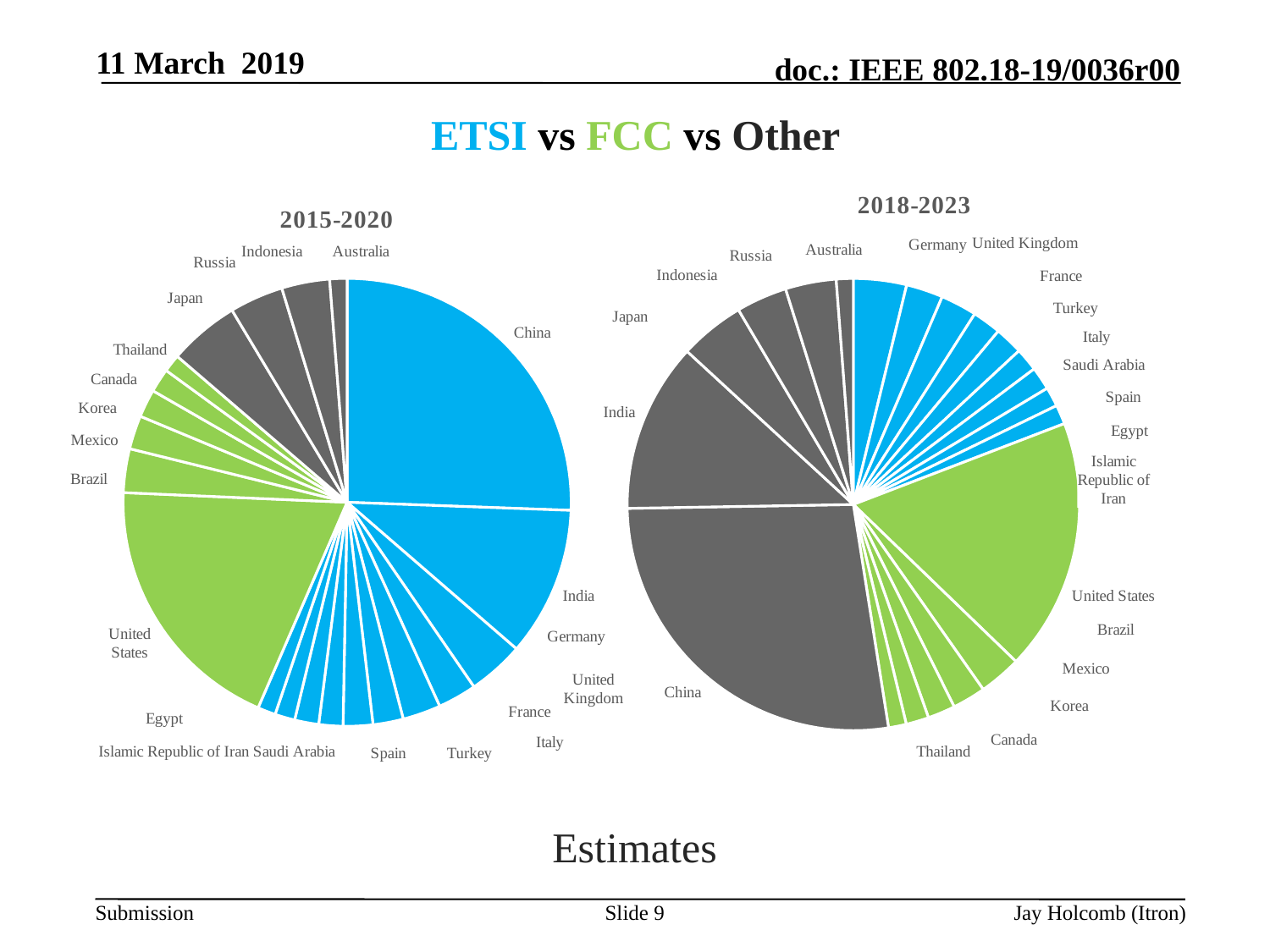
In the 2018-2023 chart, what colour is the China slice? grey In the 2015-2020 chart, which country has the largest slice? China What kind of chart is the 2018-2023 chart? pie chart In the 2018-2023 chart, which slice is larger, India or Japan? India What kind of chart is the 2015-2020 chart? pie chart In the 2018-2023 chart, which country has the largest slice? China In the 2015-2020 chart, which slice is larger, United States or Egypt? United States In the 2015-2020 chart, which slice is larger, China or India? China What is the title of the slide containing the two pie charts? ETSI vs FCC vs Other How many slices does the 2015-2020 pie chart have? 21 How many slices does the 2018-2023 pie chart have? 21